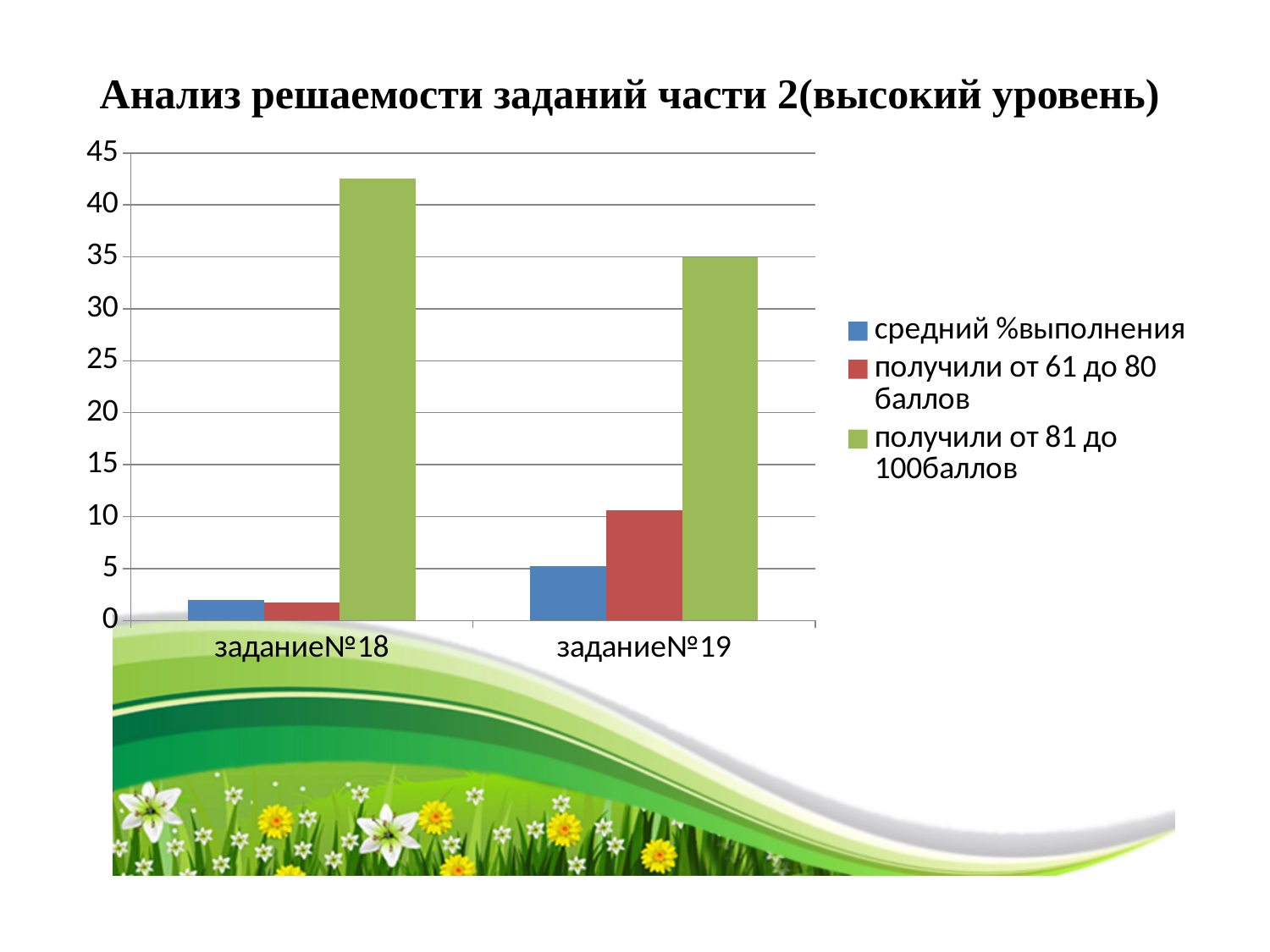
Which series has the highest bar for задание№19? получили от 81 до 100баллов Which is larger: 'средний %выполнения' for задание№18 or for задание№19? задание№19 What is the title of the chart? Анализ решаемости заданий части 2(высокий уровень) Which category has the lowest value for the series 'получили от 61 до 80 баллов'? задание№18 Is the value for 'получили от 61 до 80 баллов' at задание№19 greater or less than 5? greater How many categories are shown on the x axis? 2 Which category has the highest value for the series 'получили от 81 до 100баллов'? задание№18 Is the value for 'средний %выполнения' at задание№18 greater or less than 5? less Is the value for 'получили от 81 до 100баллов' at задание№18 greater or less than 40? greater How many series does the legend list? 3 Does the value for 'получили от 81 до 100баллов' rise or fall from задание№18 to задание№19? fall What kind of chart is shown on the slide? bar chart